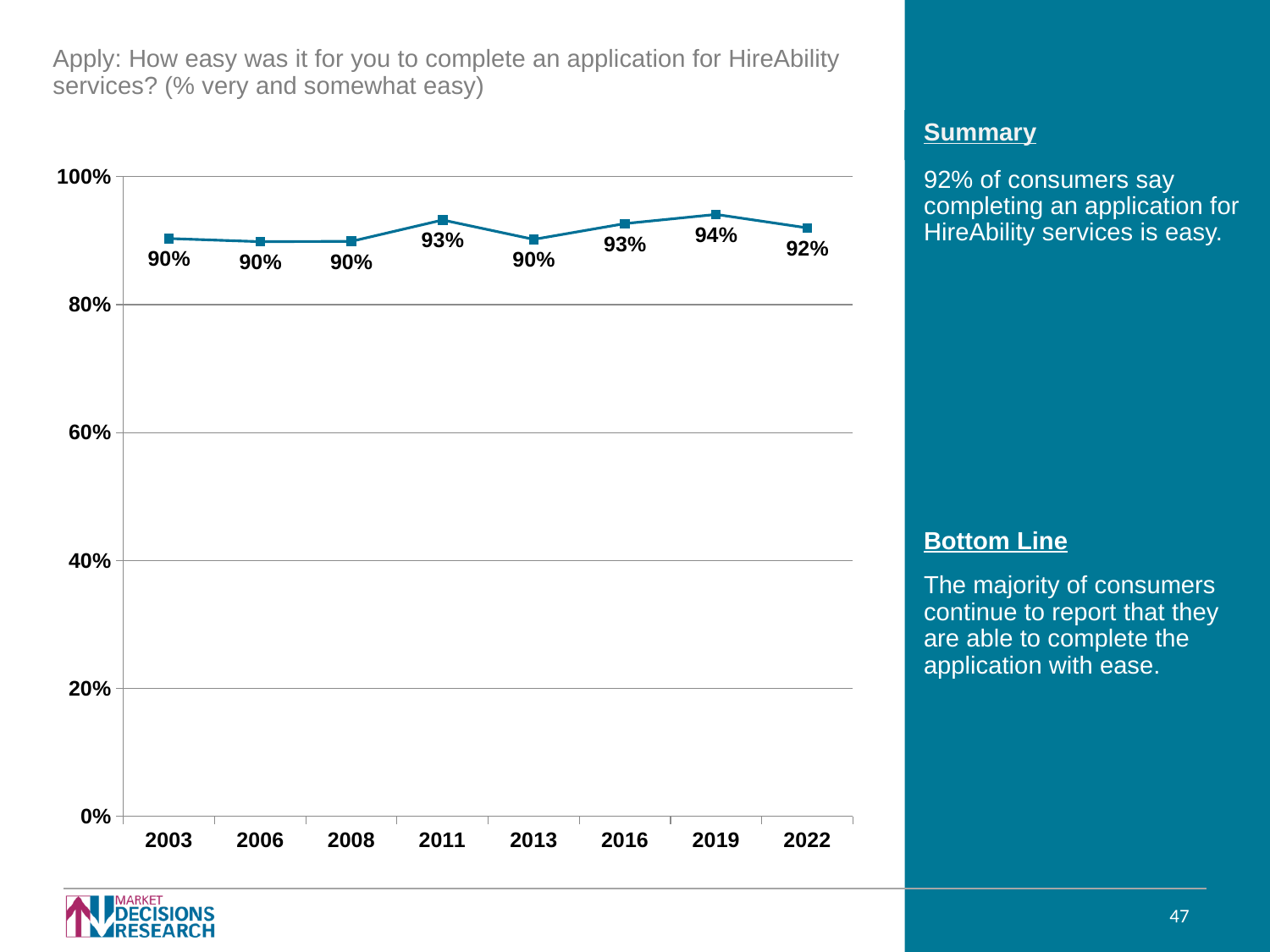
What is the difference between the values for 2022 and 2006? 2% What is the value for 2022? 92% What is the difference between the values for 2019 and 2013? 4% What is the value for 2011? 93% Does the value rise or fall from 2019 to 2022? fall Which is larger, the value for 2016 or the value for 2022? 2016 What is the value for 2003? 90% What is the highest value shown on the y axis? 100% What kind of chart is shown? line chart Which year has the highest value? 2019 How many years are plotted on the chart? 8 Is the value for 2008 greater or less than 80%? greater